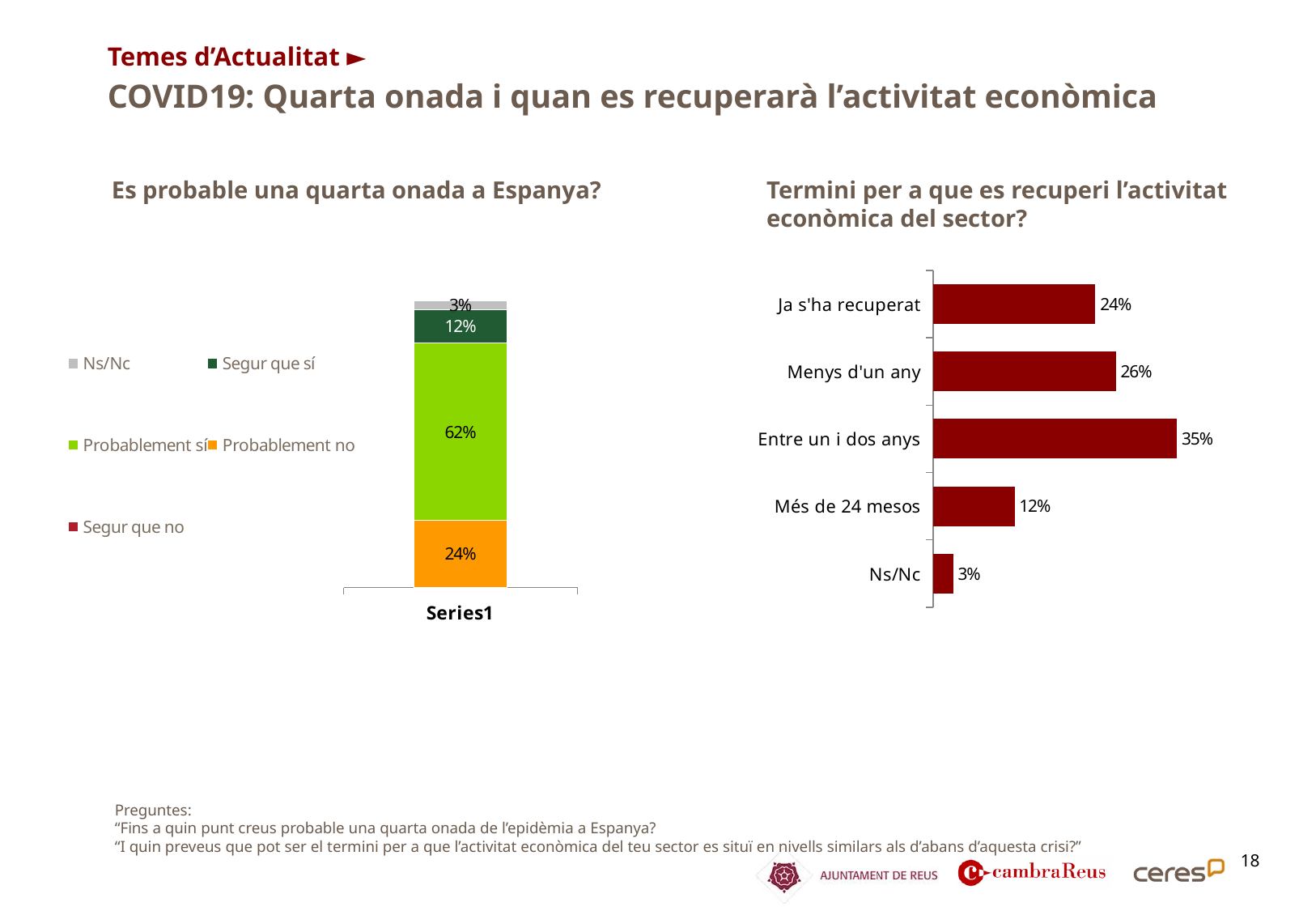
What kind of chart is 'Termini per a que es recuperi l'activitat econòmica del sector?'? Bar chart In the chart 'Termini per a que es recuperi l'activitat econòmica del sector?', which category has the highest value? Entre un i dos anys In the chart 'Es probable una quarta onada a Espanya?', what is the value for 'Segur que sí'? 12% In the chart 'Es probable una quarta onada a Espanya?', how many entries does the legend list? 5 In the chart 'Termini per a que es recuperi l'activitat econòmica del sector?', what is the difference between 'Menys d'un any' and 'Ja s'ha recuperat'? 2% In the chart 'Es probable una quarta onada a Espanya?', what is the value for 'Probablement sí'? 62% In the chart 'Es probable una quarta onada a Espanya?', which legend entry has the largest segment? Probablement sí In the chart 'Termini per a que es recuperi l'activitat econòmica del sector?', what is the value for 'Entre un i dos anys'? 35% In the chart 'Termini per a que es recuperi l'activitat econòmica del sector?', which category has the lowest value? Ns/Nc In the chart 'Termini per a que es recuperi l'activitat econòmica del sector?', how many categories are shown? 5 In the chart 'Termini per a que es recuperi l'activitat econòmica del sector?', what is the value for 'Més de 24 mesos'? 12% In the chart 'Es probable una quarta onada a Espanya?', what is the value for 'Probablement no'? 24%